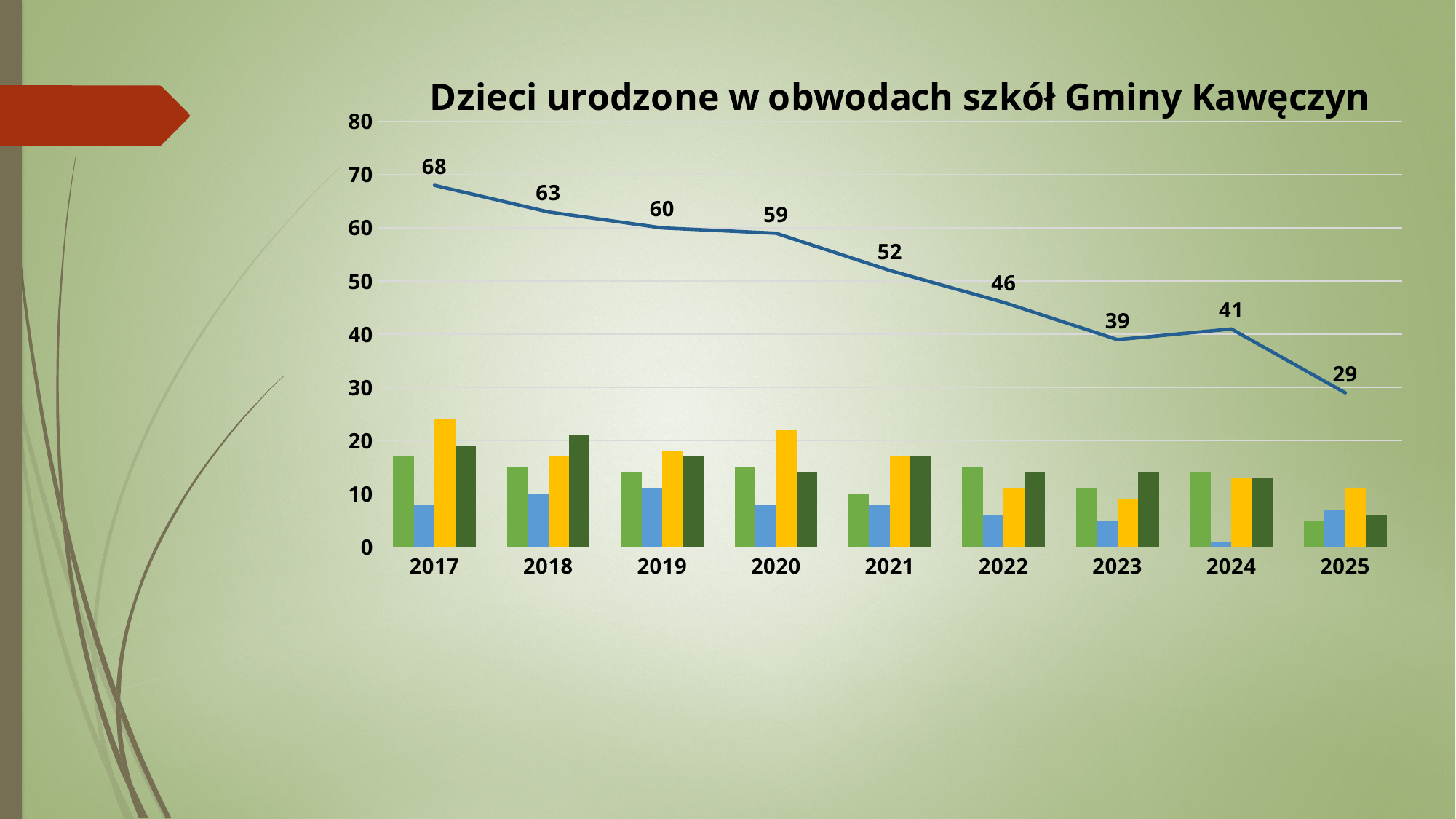
What is the title of the chart? Dzieci urodzone w obwodach szkół Gminy Kawęczyn How many years are shown on the x axis? 9 In which year does the line reach its highest value? 2017 Which year has the larger line value, 2023 or 2024? 2024 What is the value of the line for 2017? 68 What is the value of the line for 2025? 29 What is the value of the line for 2021? 52 Does the line generally rise or fall from 2017 to 2025? fall What is the difference between the line values for 2017 and 2025? 39 Is the value of the yellow bar for 2017 greater or less than 20? greater Is the value of the blue bar for 2024 greater or less than 10? less In which year does the line reach its lowest value? 2025